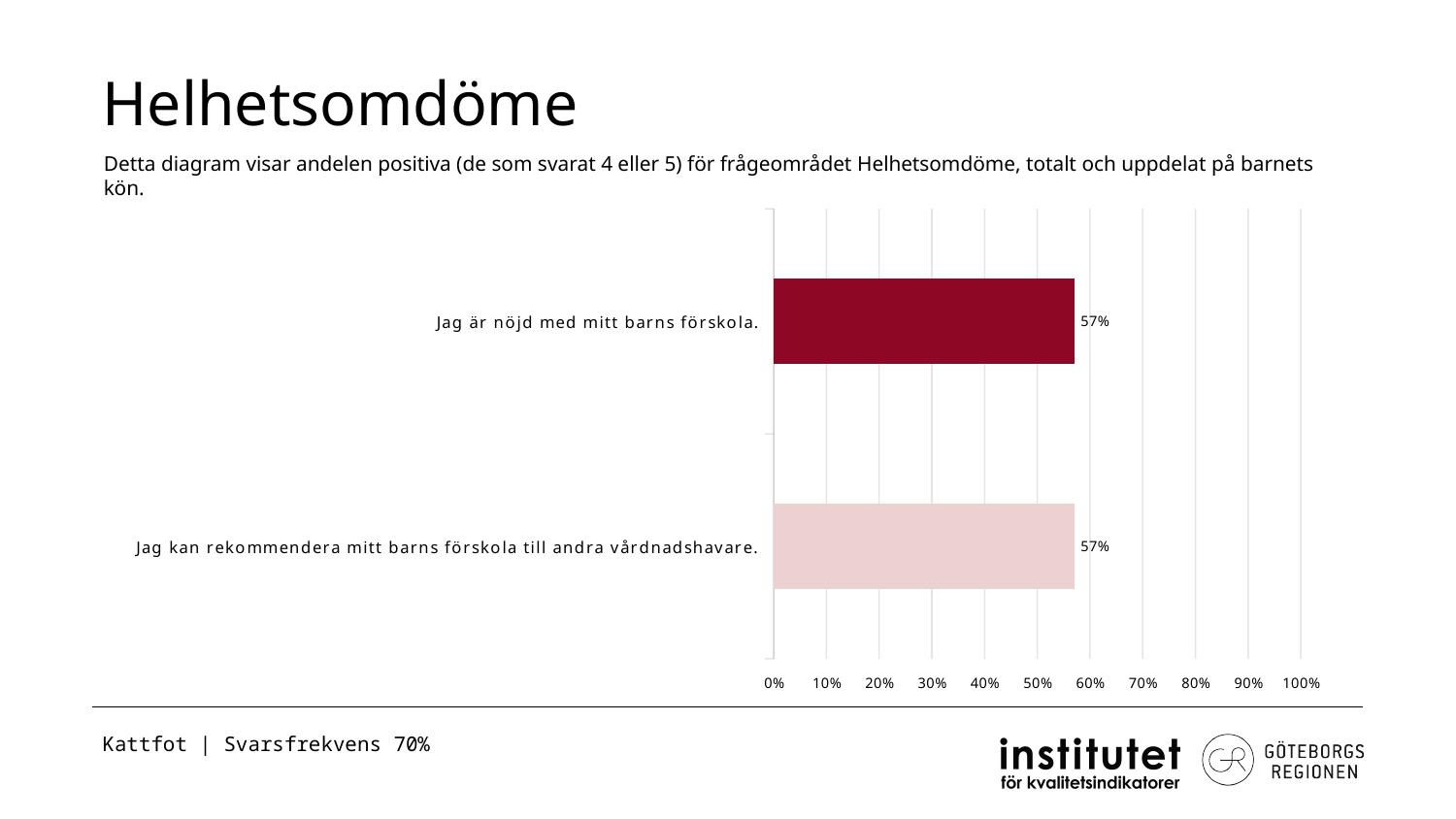
What kind of chart is shown on the slide? Bar chart How many categories (bars) are shown in the chart? 2 What is the value for "Jag är nöjd med mitt barns förskola."? 57% What is the highest value shown on the x axis of the chart? 100% Is the value for "Jag är nöjd med mitt barns förskola." greater or less than 50%? greater What is the value for "Jag kan rekommendera mitt barns förskola till andra vårdnadshavare."? 57% What is the difference between the values for "Jag är nöjd med mitt barns förskola." and "Jag kan rekommendera mitt barns förskola till andra vårdnadshavare."? 0% Is the value for "Jag kan rekommendera mitt barns förskola till andra vårdnadshavare." greater or less than 60%? less What is the title of the slide containing the chart? Helhetsomdöme